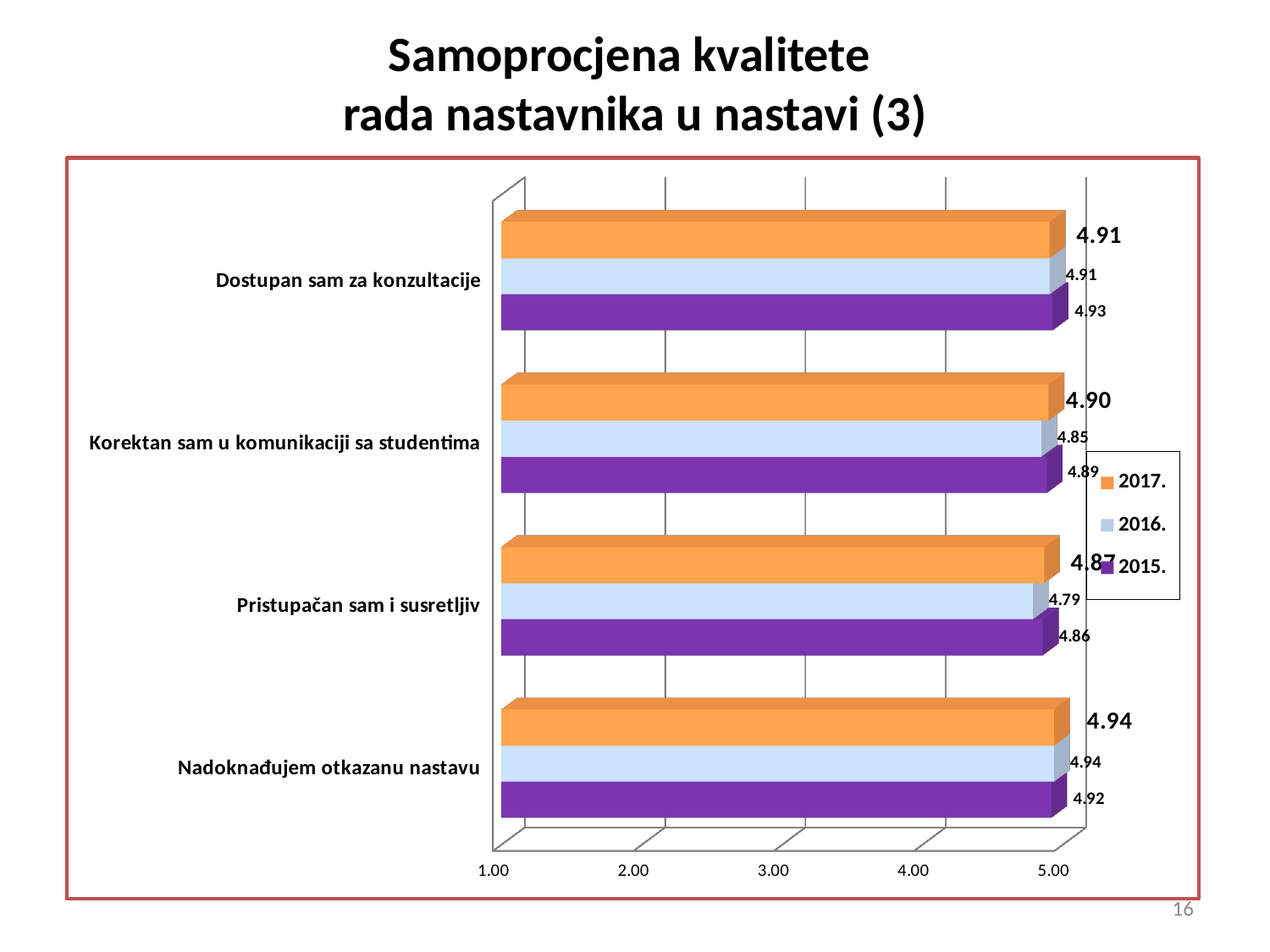
What is the value for "Korektan sam u komunikaciji sa studentima" in the 2017. series? 4.90 How many categories are shown on the chart? 4 Which category has the lowest value in the 2016. series? Pristupačan sam i susretljiv What is the value for "Pristupačan sam i susretljiv" in the 2016. series? 4.79 What is the value for "Dostupan sam za konzultacije" in the 2015. series? 4.93 Which series is shown in orange in the legend? 2017. What is the difference between the 2017. and 2016. values for "Pristupačan sam i susretljiv"? 0.08 For "Korektan sam u komunikaciji sa studentima", which is larger: the 2016. value or the 2015. value? 2015. What is the value for "Nadoknađujem otkazanu nastavu" in the 2016. series? 4.94 Which category has the highest value in the 2017. series? Nadoknađujem otkazanu nastavu What kind of chart is shown on the slide? Bar chart How many series does the legend list? 3